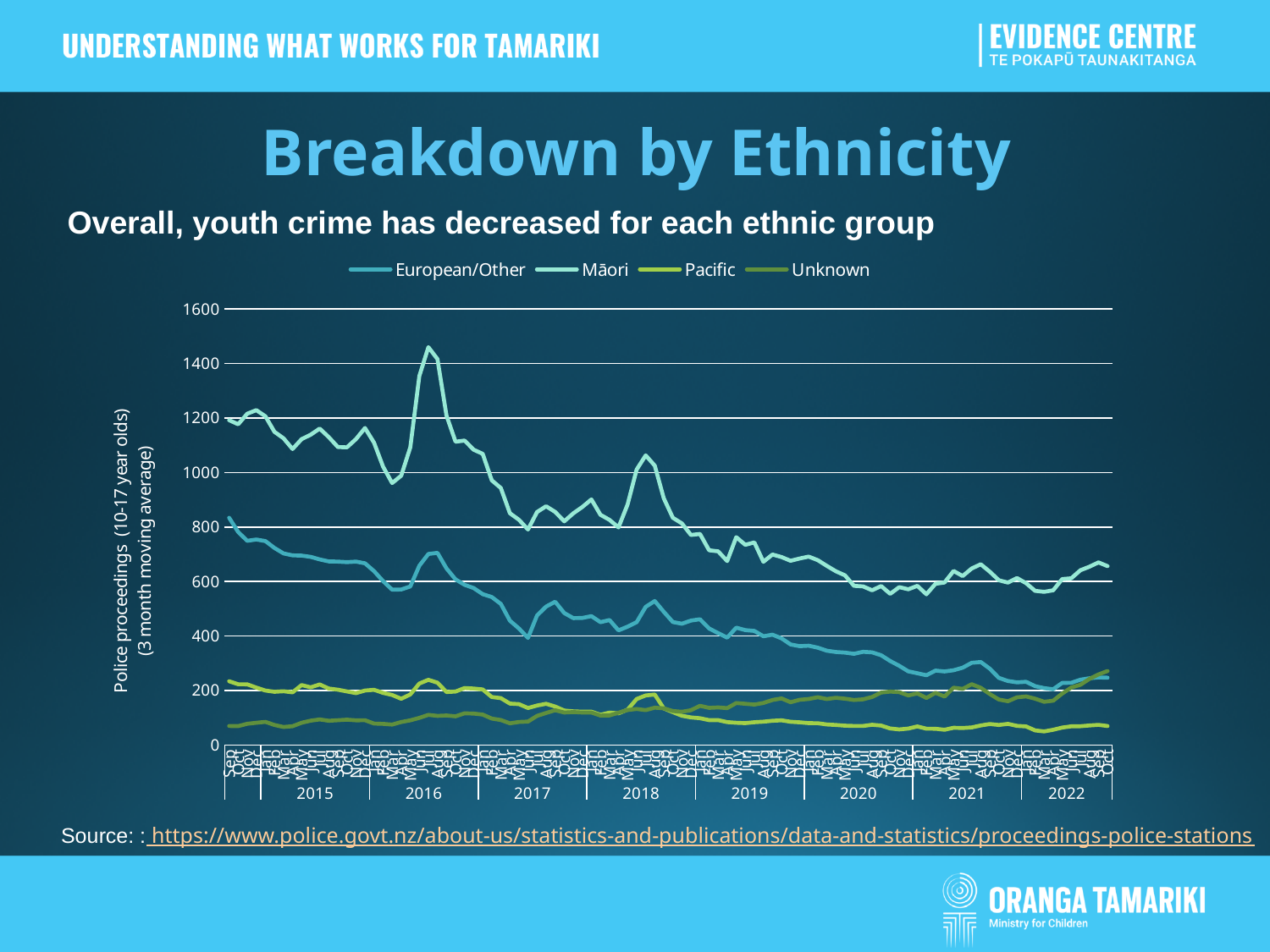
Does the European/Other series rise or fall overall from 2015 to 2022? fall Which series has the highest values across the chart? Māori How many year labels are shown on the x axis? 8 What is the label on the y axis? Police proceedings (10-17 year olds) (3 month moving average) Is the peak value for Māori in 2016 greater or less than 1200? greater Is the value for Unknown in 2019 greater or less than 200? less How many series does the legend list? 4 In 2018, which series has larger values, Māori or European/Other? Māori Does the Māori series rise or fall overall from 2015 to 2022? fall What type of chart is shown on the slide? line chart Is the value for European/Other in 2021 greater or less than 400? less